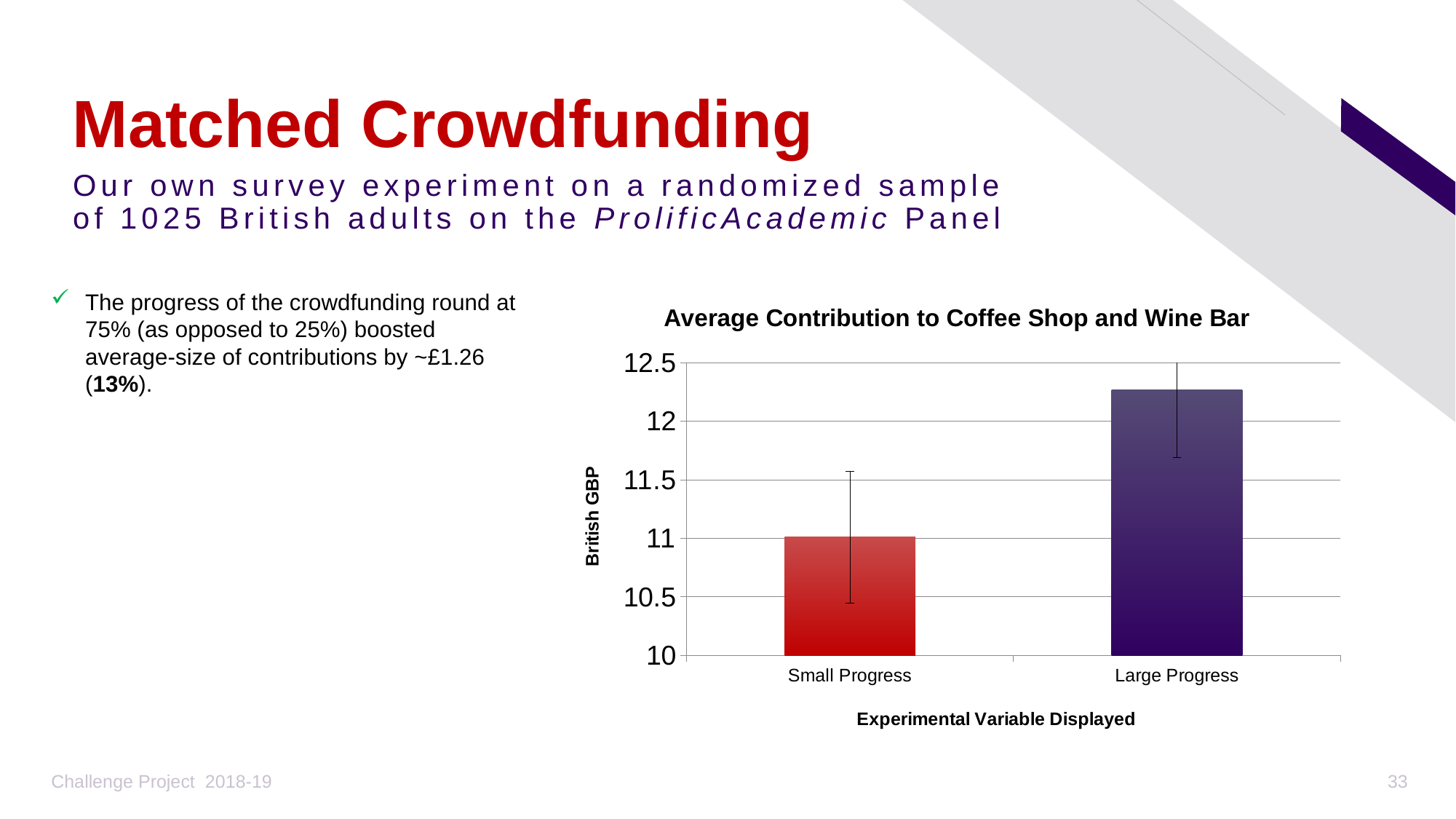
What is the label of the y axis of the chart? British GBP Is the value for Large Progress greater or less than 12.5? less Do the values rise or fall from Small Progress to Large Progress? rise How many categories are plotted on the x axis of the chart? 2 Is the value for Small Progress greater or less than 11.5? less Is the value for Small Progress greater or less than 10.5? greater Which category has the highest average contribution? Large Progress What is the title of the chart? Average Contribution to Coffee Shop and Wine Bar Which category has the lowest average contribution? Small Progress Which is larger, the value for Small Progress or the value for Large Progress? Large Progress What kind of chart is shown on the slide? bar chart